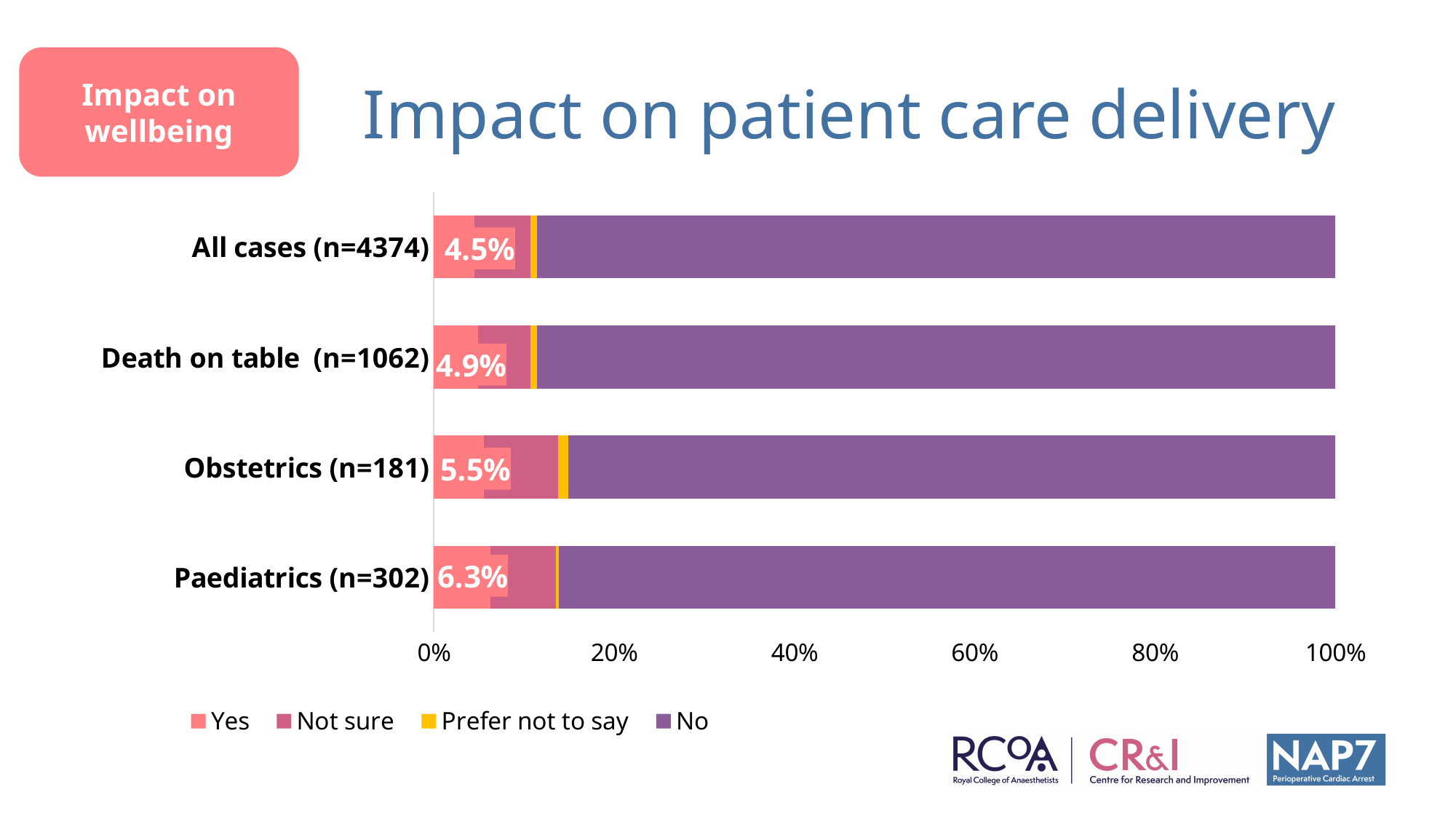
Which category has the highest 'Yes' value? Paediatrics (n=302) What is the difference between the 'Yes' values for Paediatrics (n=302) and All cases (n=4374)? 1.8% Is the 'No' value for All cases (n=4374) greater or less than 80%? greater What kind of chart is shown on the slide? Stacked bar chart What is the 'Yes' value for All cases (n=4374)? 4.5% What is the 'Yes' value for Obstetrics (n=181)? 5.5% How many categories are shown on the chart? 4 Which has a larger 'Yes' value, Obstetrics (n=181) or Death on table (n=1062)? Obstetrics (n=181) How many series does the legend list? 4 What is the 'Yes' value for Death on table (n=1062)? 4.9% What is the 'Yes' value for Paediatrics (n=302)? 6.3% Which category has the lowest 'Yes' value? All cases (n=4374)